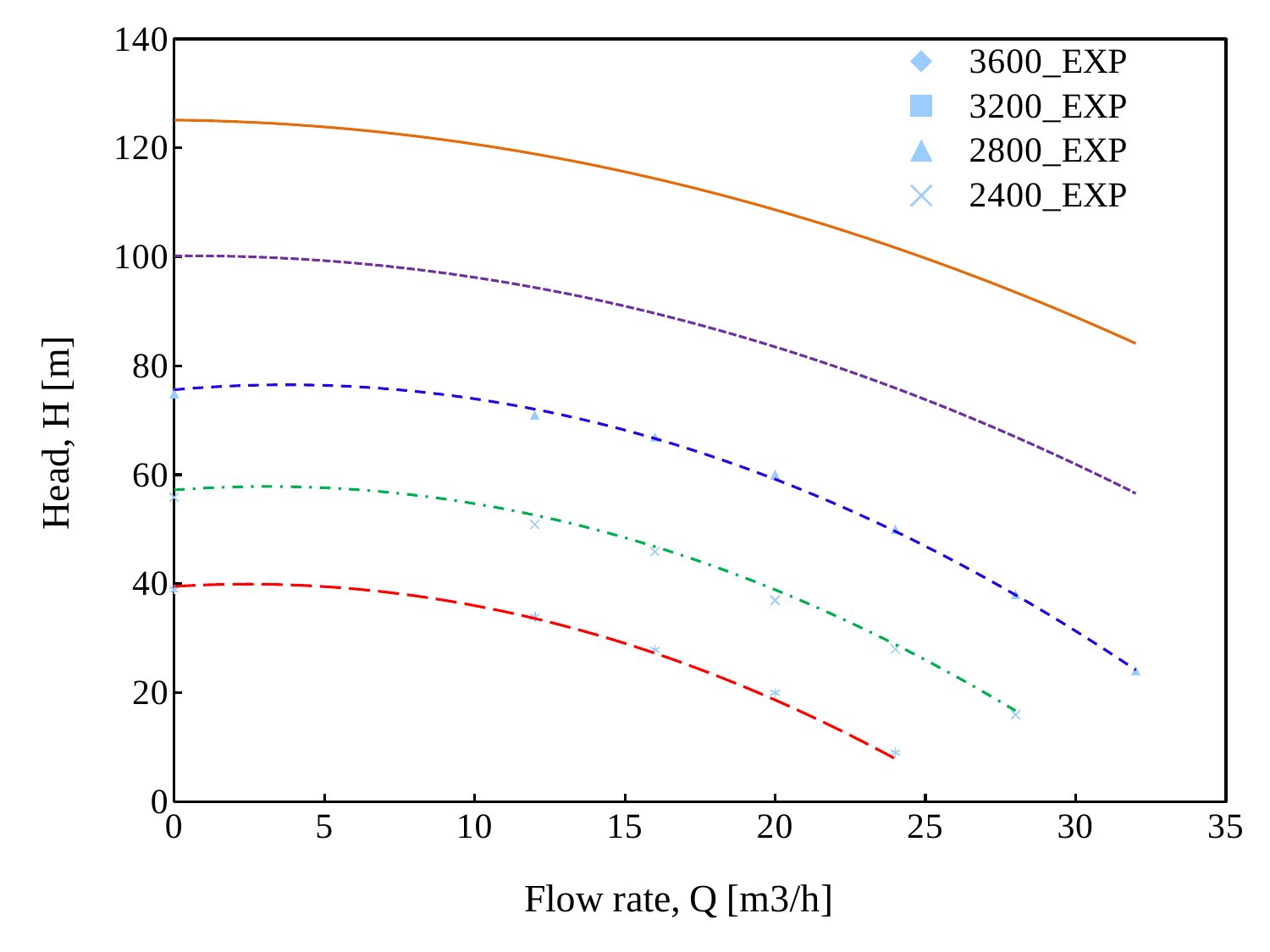
What is the label of the x axis? Flow rate, Q [m3/h] What is the label of the y axis? Head, H [m] As flow rate increases along the x axis, does the head for the 2400_EXP series rise or fall? fall At a flow rate of 20, which series has the larger head, 2800_EXP or 2400_EXP? 2800_EXP Is the head for the 2400_EXP series at a flow rate of 28 greater or less than 20? less Is the head for the 2400_EXP series at a flow rate of 0 greater or less than 60? less What kind of chart is shown on the slide? line chart How many series does the legend list? 4 Is the head for the 2800_EXP series at a flow rate of 0 greater or less than 80? less As flow rate increases along the x axis, does the head for the 2800_EXP series rise or fall? fall